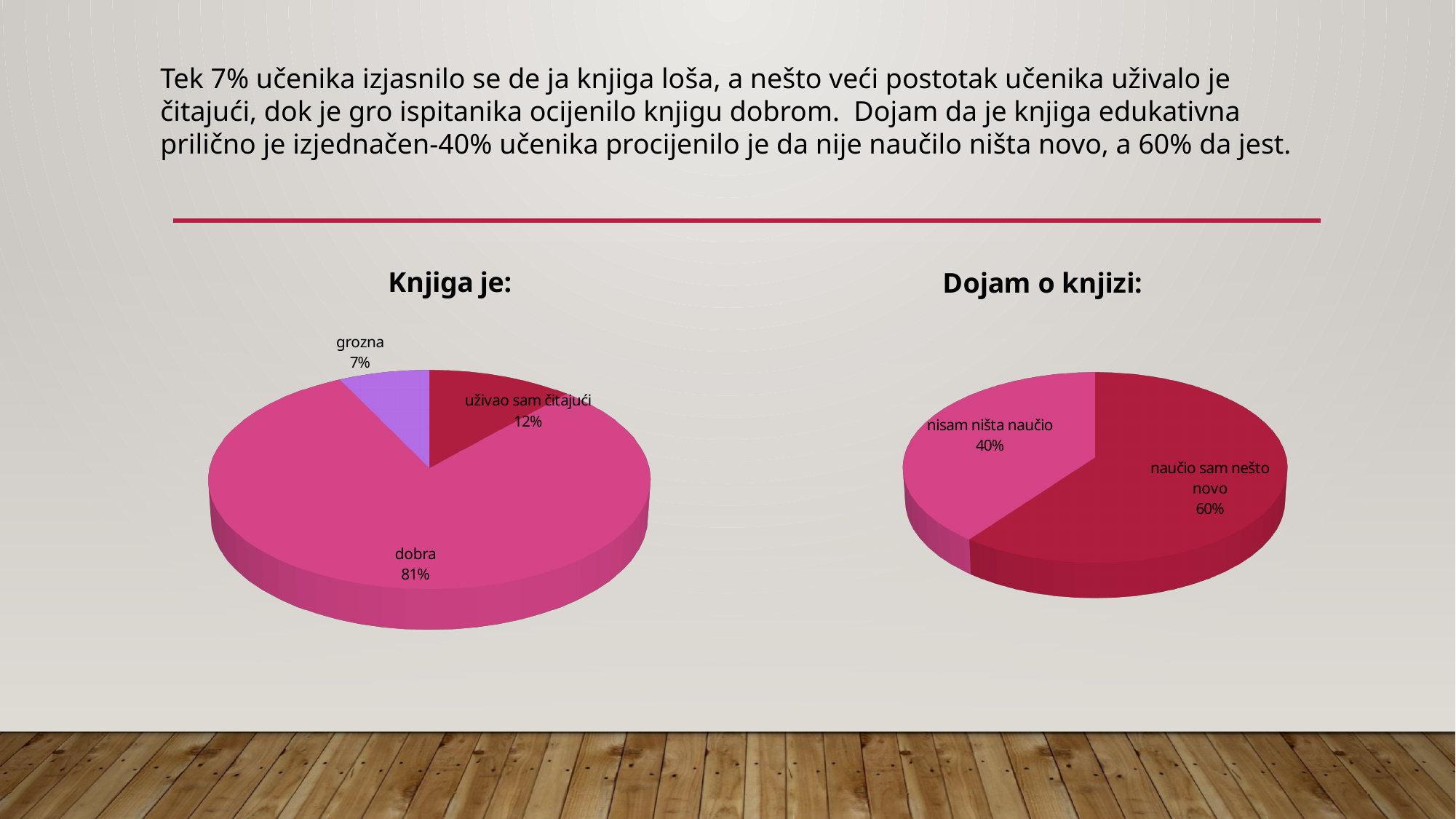
In the "Knjiga je:" chart, what share of the pie is "dobra"? 81% In the "Dojam o knjizi:" chart, what is the value for "naučio sam nešto novo"? 60% In the "Knjiga je:" chart, how many categories are shown? 3 In the "Knjiga je:" chart, what is the value for "uživao sam čitajući"? 12% In the "Knjiga je:" chart, what is the value for "grozna"? 7% In the "Dojam o knjizi:" chart, what share of the pie is "nisam ništa naučio"? 40% In the "Dojam o knjizi:" chart, what is the difference between "naučio sam nešto novo" and "nisam ništa naučio"? 20% In the "Knjiga je:" chart, which category has the largest slice? dobra In the "Knjiga je:" chart, what is the difference between "uživao sam čitajući" and "grozna"? 5% In the "Knjiga je:" chart, which category has the smallest slice? grozna In the "Dojam o knjizi:" chart, which is larger, "naučio sam nešto novo" or "nisam ništa naučio"? naučio sam nešto novo What kind of chart is the "Dojam o knjizi:" chart? pie chart